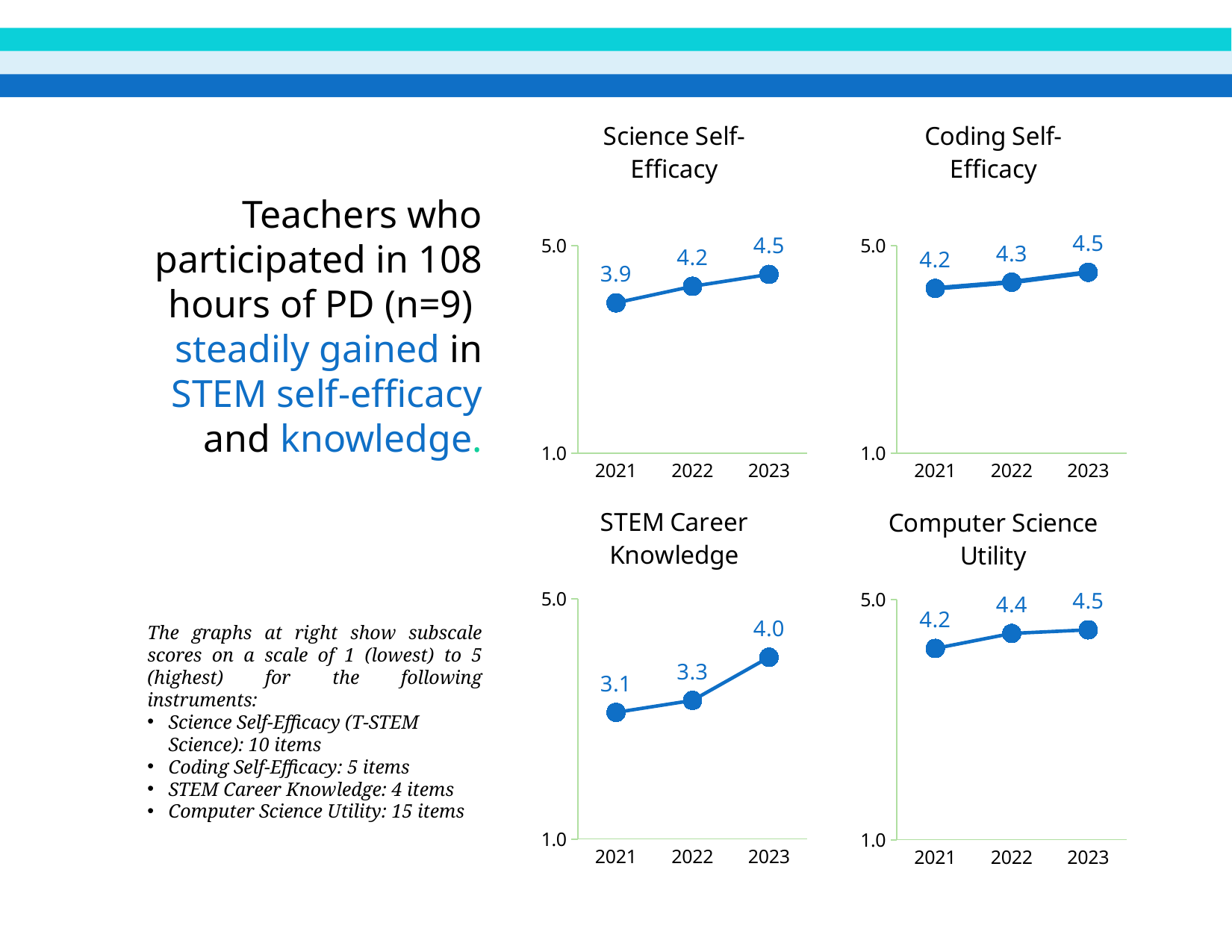
In the Coding Self-Efficacy chart, what is the value for 2022? 4.3 In the STEM Career Knowledge chart, which year has the lowest value? 2021 How many data points are plotted in the STEM Career Knowledge chart? 3 Which is larger: the 2021 value in the Science Self-Efficacy chart or the 2021 value in the Coding Self-Efficacy chart? Coding Self-Efficacy In the Science Self-Efficacy chart, what is the difference between the 2022 and 2021 values? 0.3 In the Science Self-Efficacy chart, what is the value for 2021? 3.9 What kind of chart is the Coding Self-Efficacy chart? line chart In the STEM Career Knowledge chart, what is the difference between the 2023 and 2021 values? 0.9 In the STEM Career Knowledge chart, what is the value for 2023? 4.0 In the Computer Science Utility chart, what is the value for 2021? 4.2 In the Science Self-Efficacy chart, which year has the highest value? 2023 In the Computer Science Utility chart, do the values rise or fall from 2021 to 2023? rise